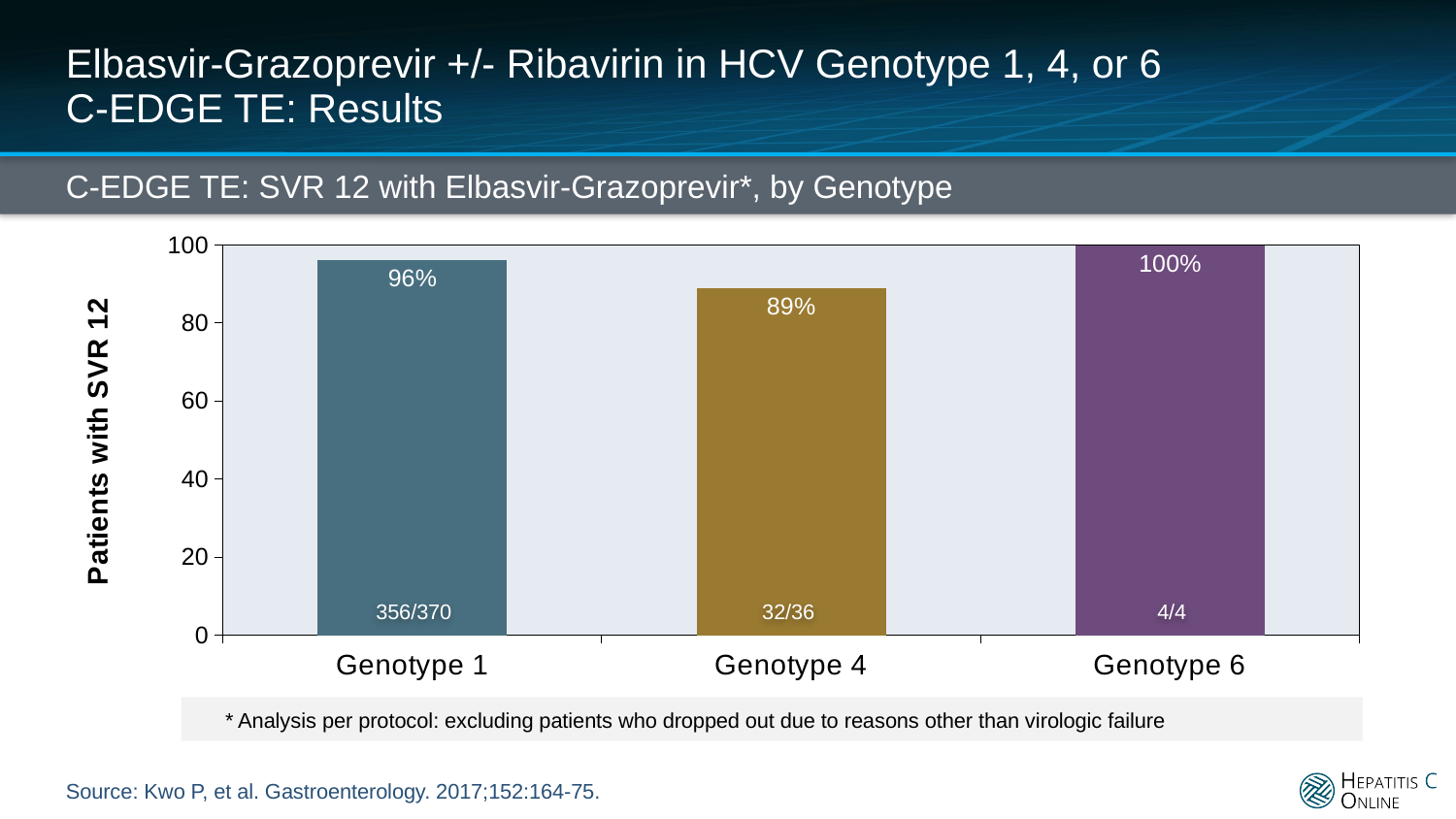
What is the SVR 12 rate for Genotype 6? 100% What fraction of patients achieved SVR 12 in the Genotype 1 group? 356/370 What is the SVR 12 rate for Genotype 1? 96% What fraction of patients achieved SVR 12 in the Genotype 4 group? 32/36 How many genotype categories are shown in the chart? 3 Which has a higher SVR 12 rate, Genotype 1 or Genotype 4? Genotype 1 Which genotype has the highest SVR 12 rate? Genotype 6 What is the difference in SVR 12 rate between Genotype 1 and Genotype 4? 7% What type of chart is shown on the slide? Bar chart What is the label of the y-axis? Patients with SVR 12 What is the SVR 12 rate for Genotype 4? 89% Which genotype has the lowest SVR 12 rate? Genotype 4